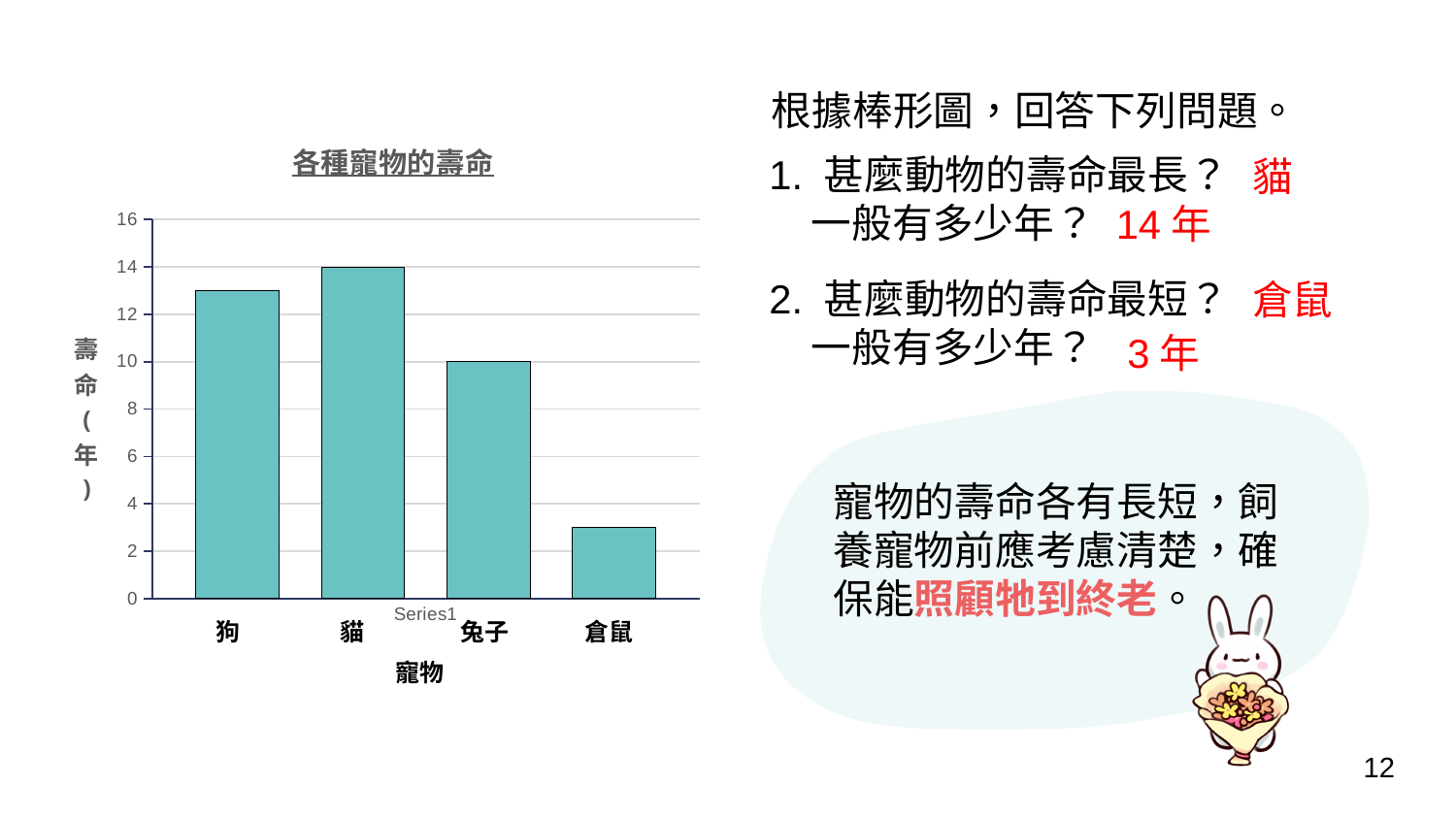
Which has a larger value, 狗 or 兔子? 狗 What is the title of the chart? 各種寵物的壽命 What is the label on the y axis of the chart? 壽命(年) What is the lifespan value shown for 貓? 14 How many pet categories are plotted on the x axis? 4 What kind of chart is shown on the slide? bar chart What is the lifespan value shown for 兔子? 10 What is the difference between the values for 貓 and 兔子? 4 Is the value for 狗 greater or less than 12? greater Which pet has the longest lifespan in the chart? 貓 Which pet has the shortest lifespan in the chart? 倉鼠 What is the lifespan value shown for 倉鼠? 3